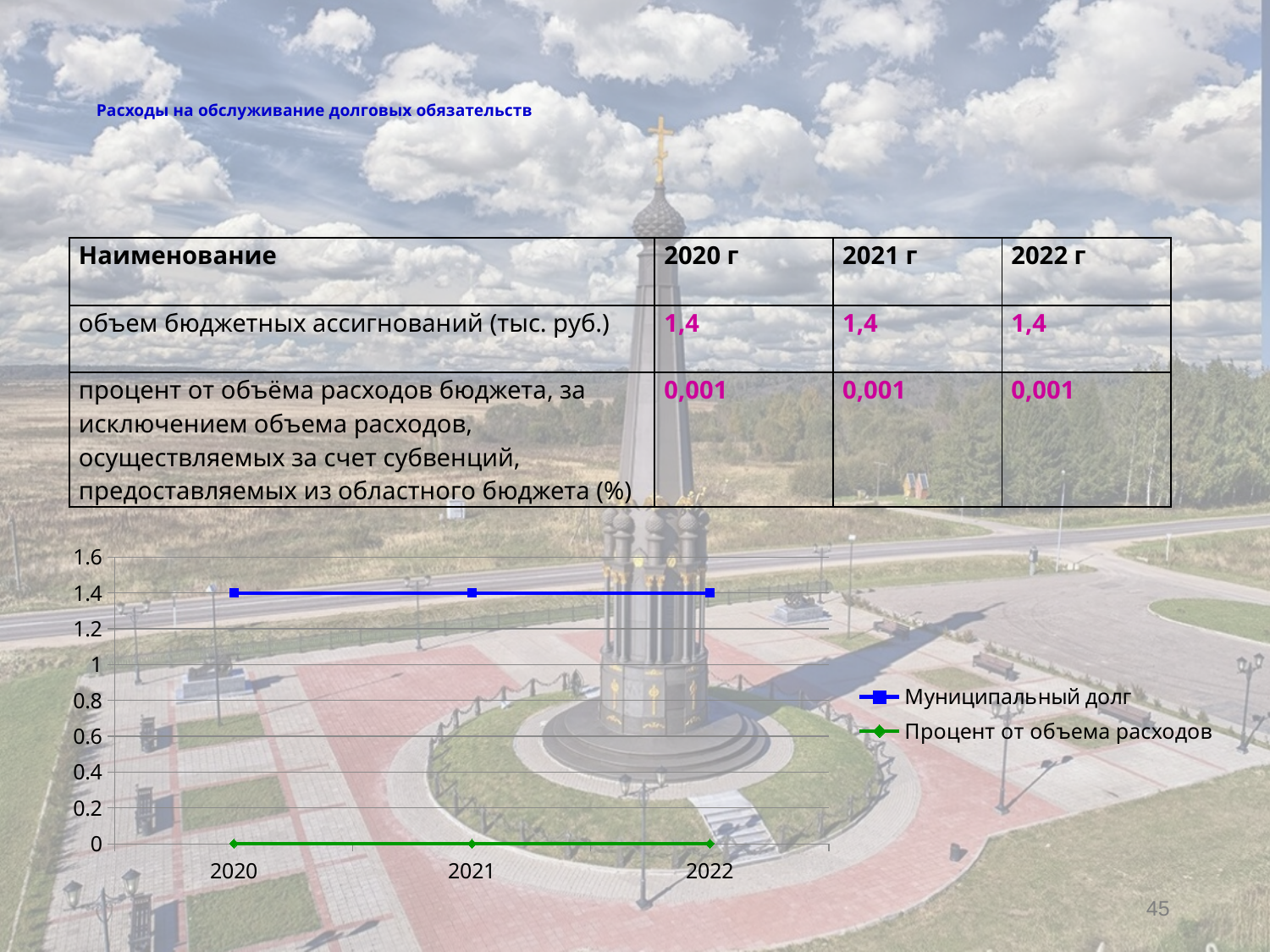
Which years are shown on the x axis of the chart? 2020, 2021, 2022 What colour is the Муниципальный долг line in the chart? blue Is the value for Процент от объема расходов in 2020 greater or less than 0.2? less What is the value of Муниципальный долг in 2021 according to the chart? 1.4 Does the Муниципальный долг line rise, fall or stay flat from 2020 to 2022? stays flat What is the value of Муниципальный долг in 2020 according to the chart? 1.4 Is the value for Муниципальный долг in 2022 greater or less than 1? greater How many years are plotted along the x axis of the chart? 3 How many series does the chart legend list? 2 Is the value for Процент от объема расходов in 2022 greater or less than 0.4? less What kind of chart is shown on the slide? line chart Which series has the higher value in 2022, Муниципальный долг or Процент от объема расходов? Муниципальный долг